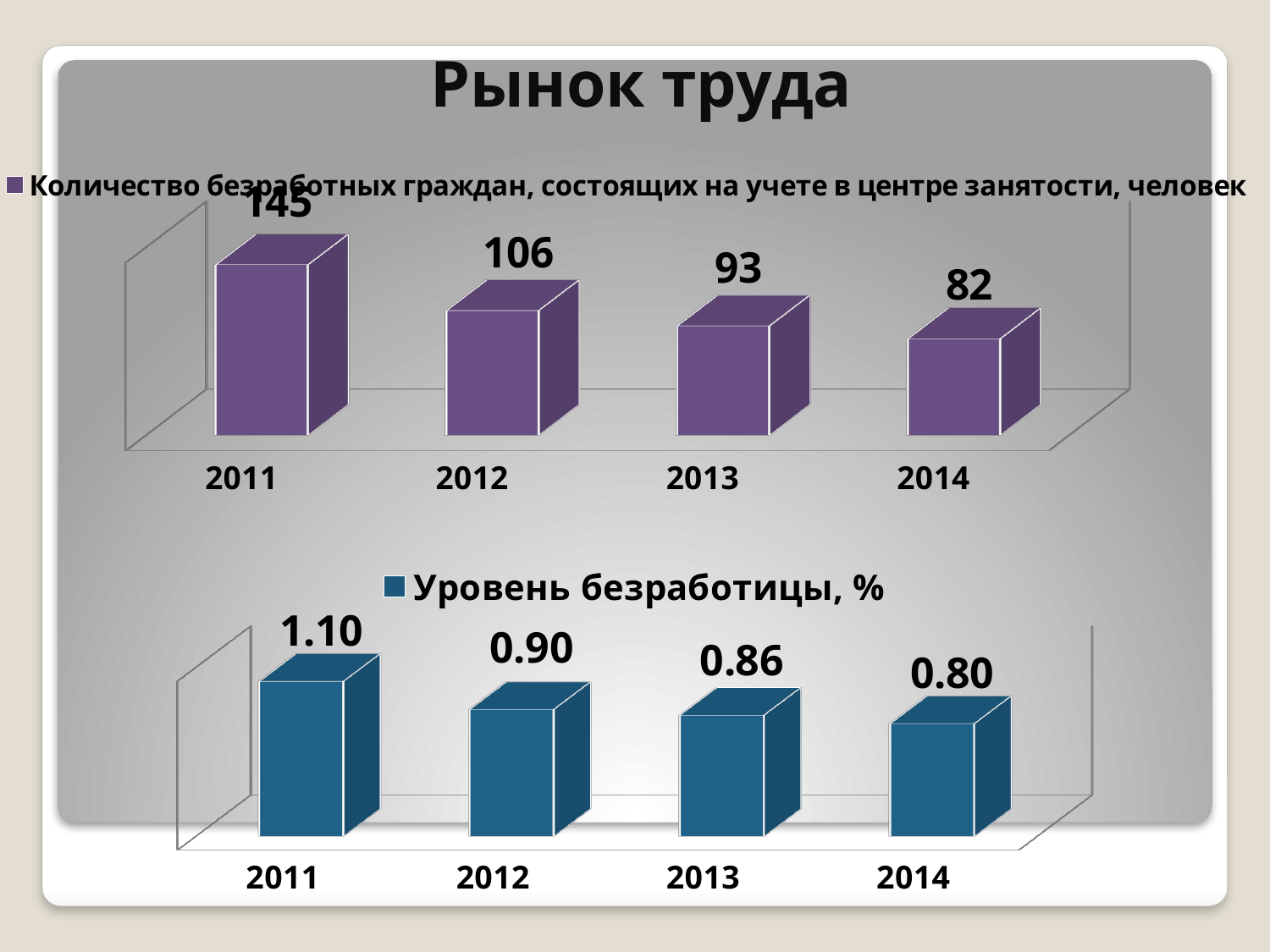
In the bottom chart (Уровень безработицы, %), which year has the highest value? 2011 In the bottom chart (Уровень безработицы, %), which is larger, the value for 2013 or the value for 2014? 2013 In the bottom chart (Уровень безработицы, %), what is the difference between the 2011 and 2014 values? 0.30 In the top chart (Количество безработных граждан), what is the value for 2011? 145 In the bottom chart (Уровень безработицы, %), what is the value for 2012? 0.90 In the top chart (Количество безработных граждан), do the values rise or fall from 2011 to 2014? fall In the top chart (Количество безработных граждан), what is the value for 2013? 93 In the top chart (Количество безработных граждан), what is the difference between the 2011 and 2012 values? 39 In the top chart (Количество безработных граждан), how many years are shown? 4 In the top chart (Количество безработных граждан), which year has the lowest value? 2014 In the bottom chart (Уровень безработицы, %), what is the value for 2014? 0.80 What kind of chart is the bottom chart (Уровень безработицы, %)? bar chart